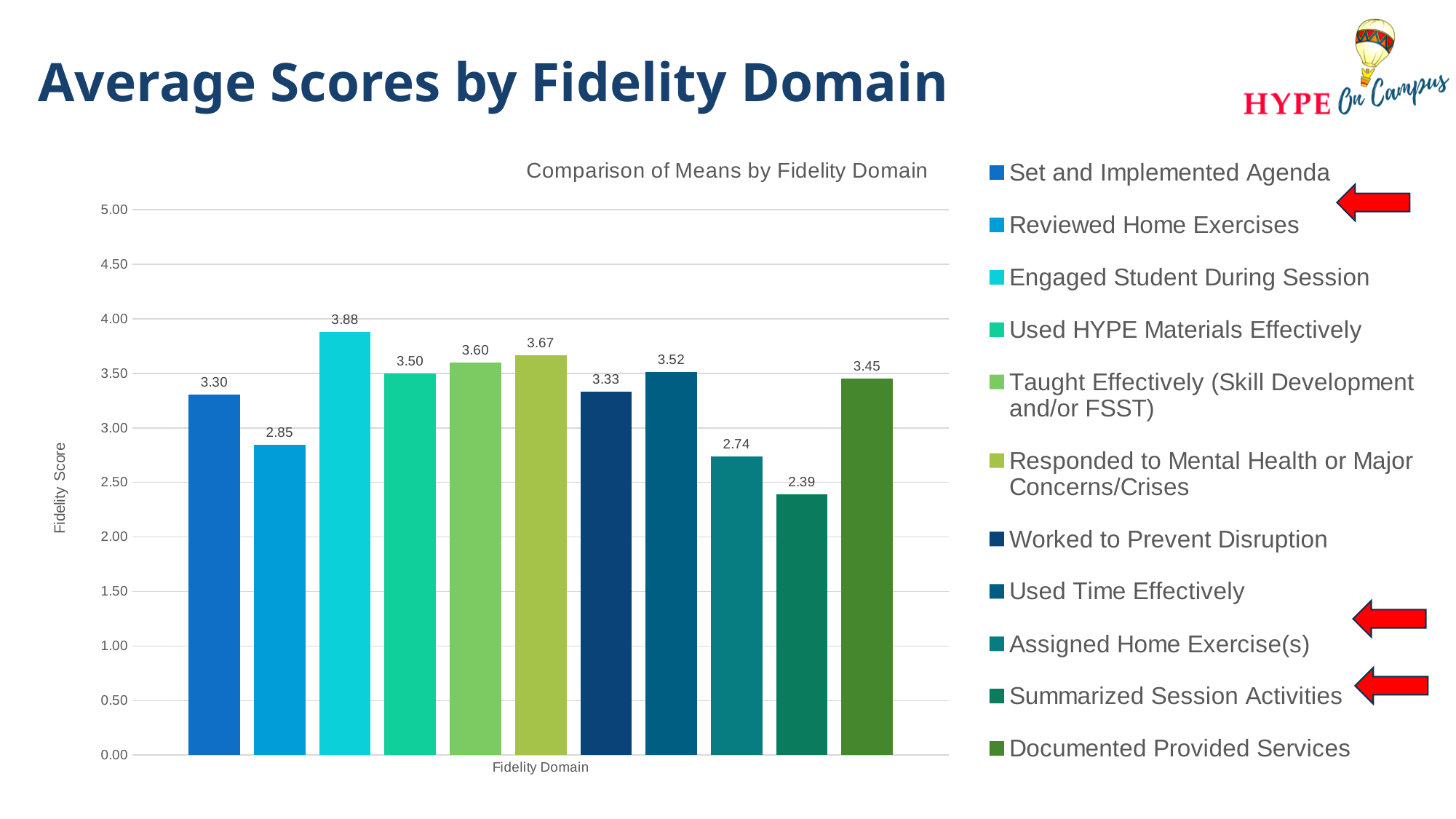
What is the average score for Assigned Home Exercise(s)? 2.74 What is the difference between the highest score (3.88) and the lowest score (2.39)? 1.49 What is the average score for Reviewed Home Exercises? 2.85 Which has a higher average score, Used Time Effectively or Worked to Prevent Disruption? Used Time Effectively How many entries does the chart legend list? 11 Which fidelity domain has the highest average score? Engaged Student During Session How many bars are plotted in the chart? 11 Is the value for Documented Provided Services greater or less than 3.00? greater Which fidelity domain has the lowest average score? Summarized Session Activities What type of chart is shown on the slide? bar chart What is the title printed inside the chart area? Comparison of Means by Fidelity Domain What is the average score for Set and Implemented Agenda? 3.30